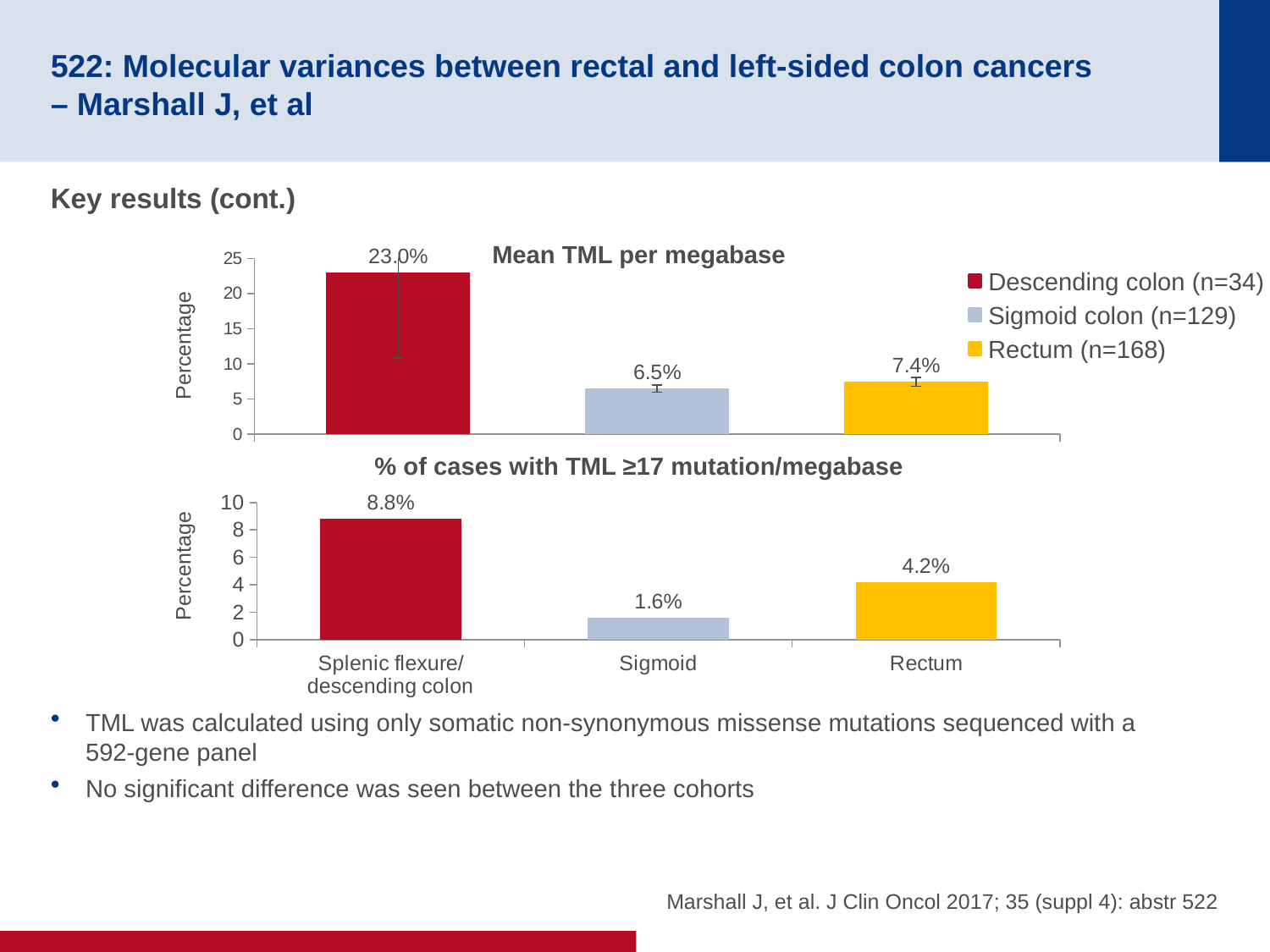
In the 'Mean TML per megabase' chart, which category has the highest value? Descending colon (n=34) What kind of chart is the '% of cases with TML ≥17 mutation/megabase' chart? Bar chart In the '% of cases with TML ≥17 mutation/megabase' chart, what is the value for Splenic flexure/descending colon? 8.8% In the 'Mean TML per megabase' chart, what is the difference between the Descending colon and Sigmoid colon values? 16.5% How many series does the legend of the 'Mean TML per megabase' chart list? 3 In the 'Mean TML per megabase' chart, what is the value for Sigmoid colon (n=129)? 6.5% In the '% of cases with TML ≥17 mutation/megabase' chart, what is the value for Sigmoid? 1.6% In the 'Mean TML per megabase' chart, what is the value for Rectum (n=168)? 7.4% In the 'Mean TML per megabase' chart, which is larger, the value for Rectum or the value for Sigmoid colon? Rectum In the 'Mean TML per megabase' chart, what is the value for Descending colon (n=34)? 23.0% In the '% of cases with TML ≥17 mutation/megabase' chart, what is the difference between the Rectum and Sigmoid values? 2.6% In the '% of cases with TML ≥17 mutation/megabase' chart, which category has the lowest value? Sigmoid